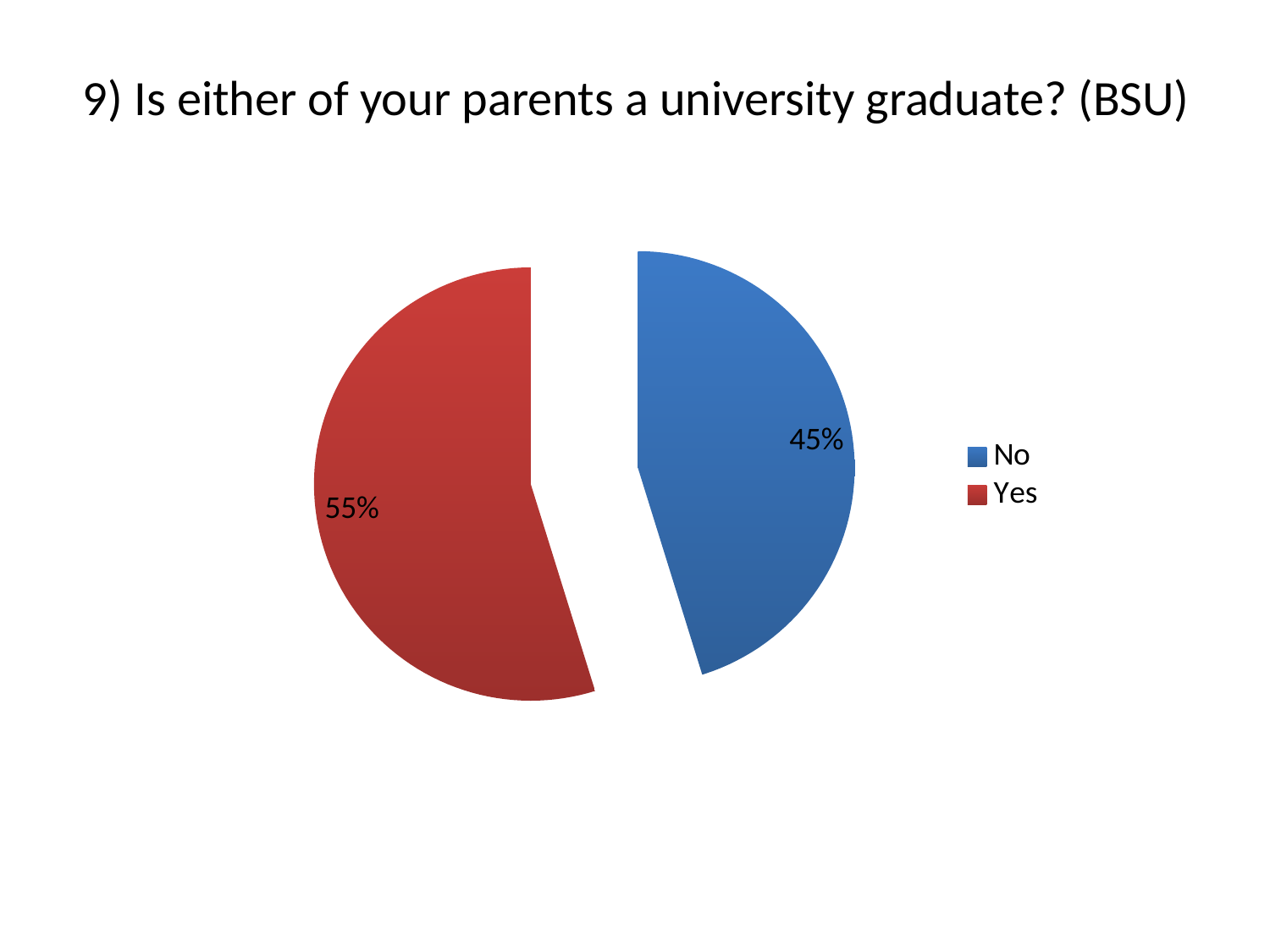
What percentage of respondents answered "Yes"? 55% What is the difference in percentage points between the "Yes" and "No" slices? 10 What kind of chart is shown on the slide? Pie chart What is the title of the slide? 9) Is either of your parents a university graduate? (BSU) How many slices does the pie chart have? 2 Which response has the largest share of the pie? Yes What percentage of respondents answered "No"? 45% What share of the pie does the "Yes" slice represent? 55% Which is larger, the "Yes" slice or the "No" slice? Yes Which response has the smallest share of the pie? No What colour is the "No" slice? Blue How many entries does the legend list? 2